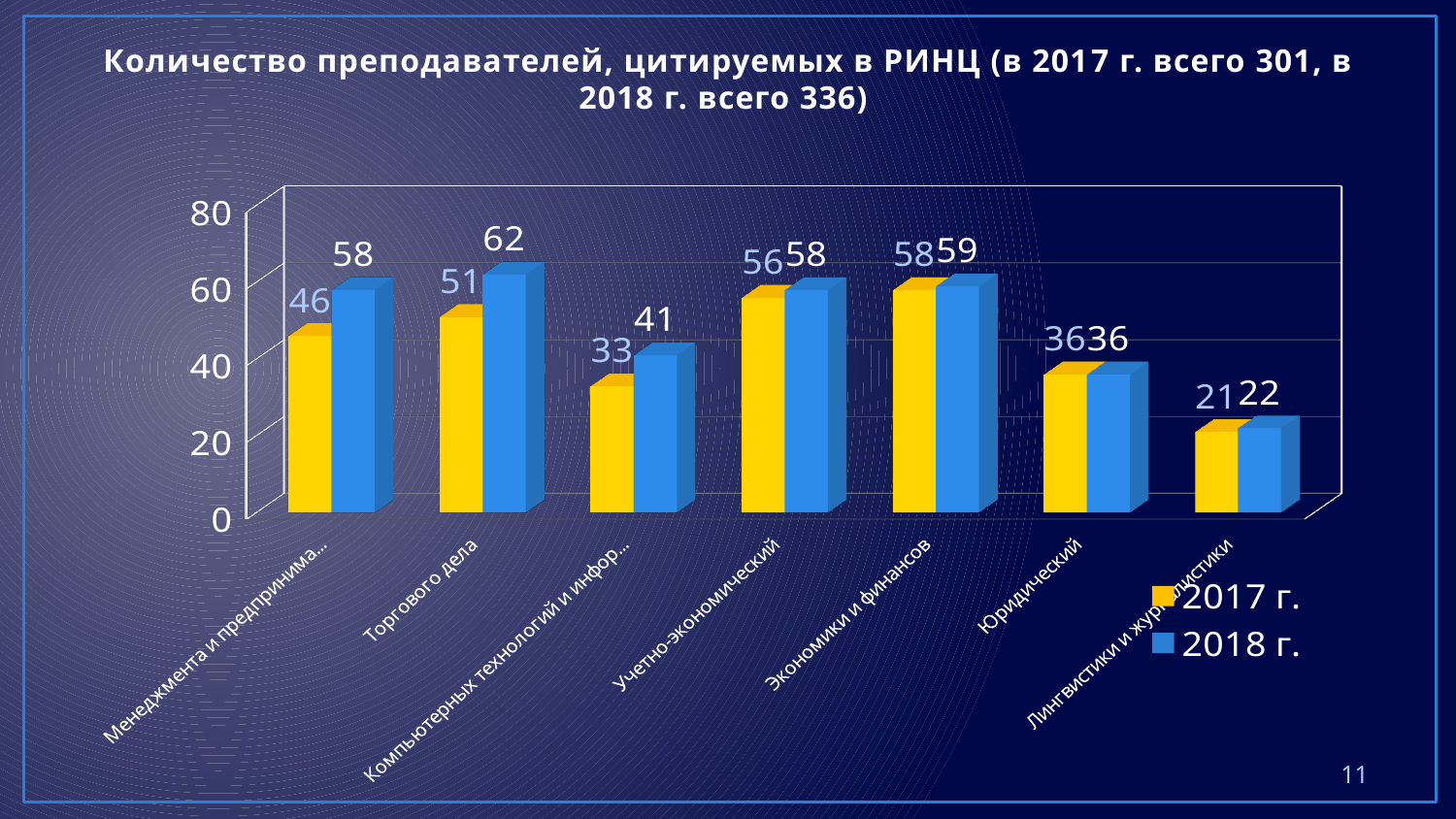
How many categories are shown on the x axis? 7 What is the value for Торгового дела in the 2018 г. series? 62 What is the value for Учетно-экономический in the 2017 г. series? 56 Which category has the lowest value in the 2017 г. series? Лингвистики и журналистики Which category has the highest value in the 2018 г. series? Торгового дела What is the difference between the 2018 г. and 2017 г. values for Торгового дела? 11 Which colour represents the 2017 г. series? Yellow What is the value for Юридический in the 2017 г. series? 36 What kind of chart is shown on the slide? Bar chart Which is larger for Учетно-экономический: the 2017 г. value or the 2018 г. value? 2018 г. What is the value for Экономики и финансов in the 2018 г. series? 59 How many series does the legend list? 2